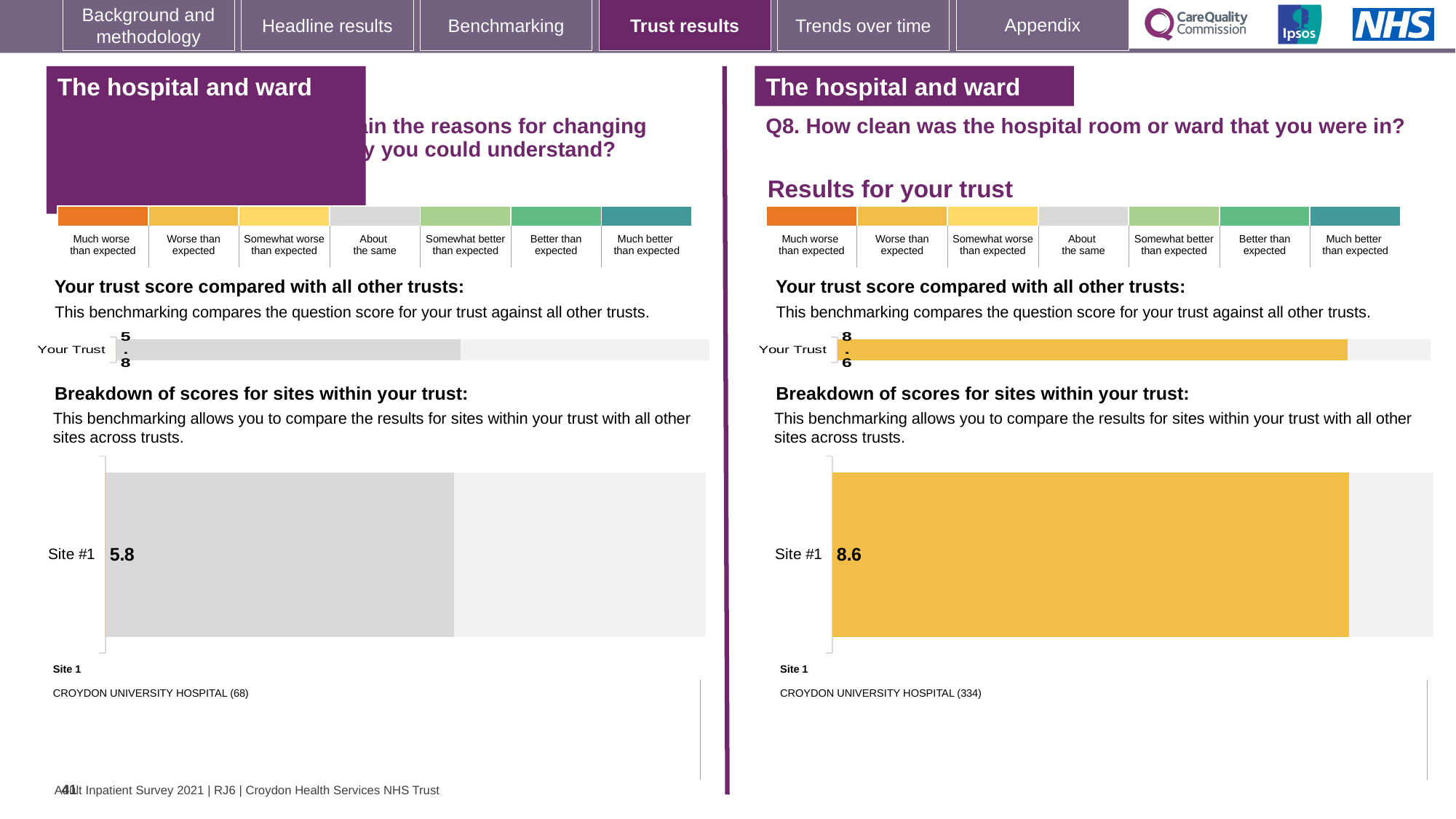
On the right-hand chart for Q8 (How clean was the hospital room or ward), what is the score shown for Your Trust? 8.6 On the right-hand Q8 site breakdown chart, which hospital is Site 1? CROYDON UNIVERSITY HOSPITAL On the left-hand site breakdown chart, what is the score for Site #1? 5.8 How many sites are shown in the right-hand Q8 site breakdown chart? 1 On the left-hand chart, what is the score shown for Your Trust? 5.8 What is the difference between the Site #1 score on the right-hand Q8 chart and the Site #1 score on the left-hand chart? 2.8 What kind of chart is used to show the Site #1 score on the right-hand Q8 breakdown? Bar chart On the right-hand site breakdown chart for Q8, what is the score for Site #1? 8.6 Which has the higher Your Trust score: the left-hand chart or the right-hand Q8 chart? The right-hand Q8 chart Which has the higher Site #1 score: the left-hand chart or the right-hand Q8 chart? The right-hand Q8 chart What colour is the Site #1 bar on the right-hand Q8 breakdown chart? Yellow